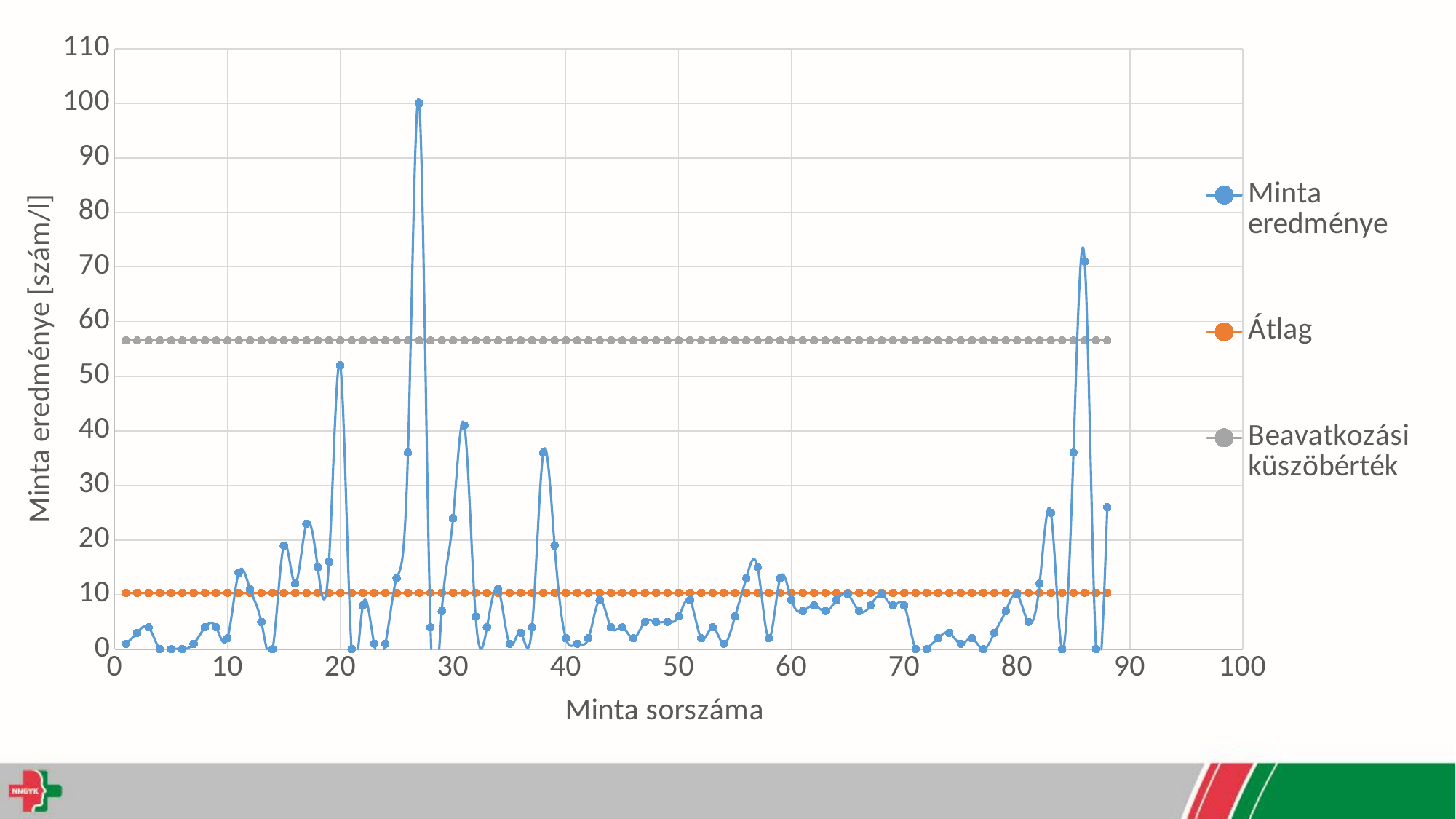
Is the Beavatkozási küszöbérték line greater or less than 60? less How many times does the Minta eredménye series rise above the Beavatkozási küszöbérték line? 2 How many series does the legend list? 3 Which is larger, the Átlag line or the Beavatkozási küszöbérték line? Beavatkozási küszöbérték What kind of chart is shown on the slide? line chart What are the three series named in the legend? Minta eredménye, Átlag, Beavatkozási küszöbérték Is the Minta eredménye value at sample 20 greater or less than 40? greater Is the Beavatkozási küszöbérték line greater or less than 50? greater What is the title of the x axis? Minta sorszáma What is the highest value reached by the Minta eredménye series? 100